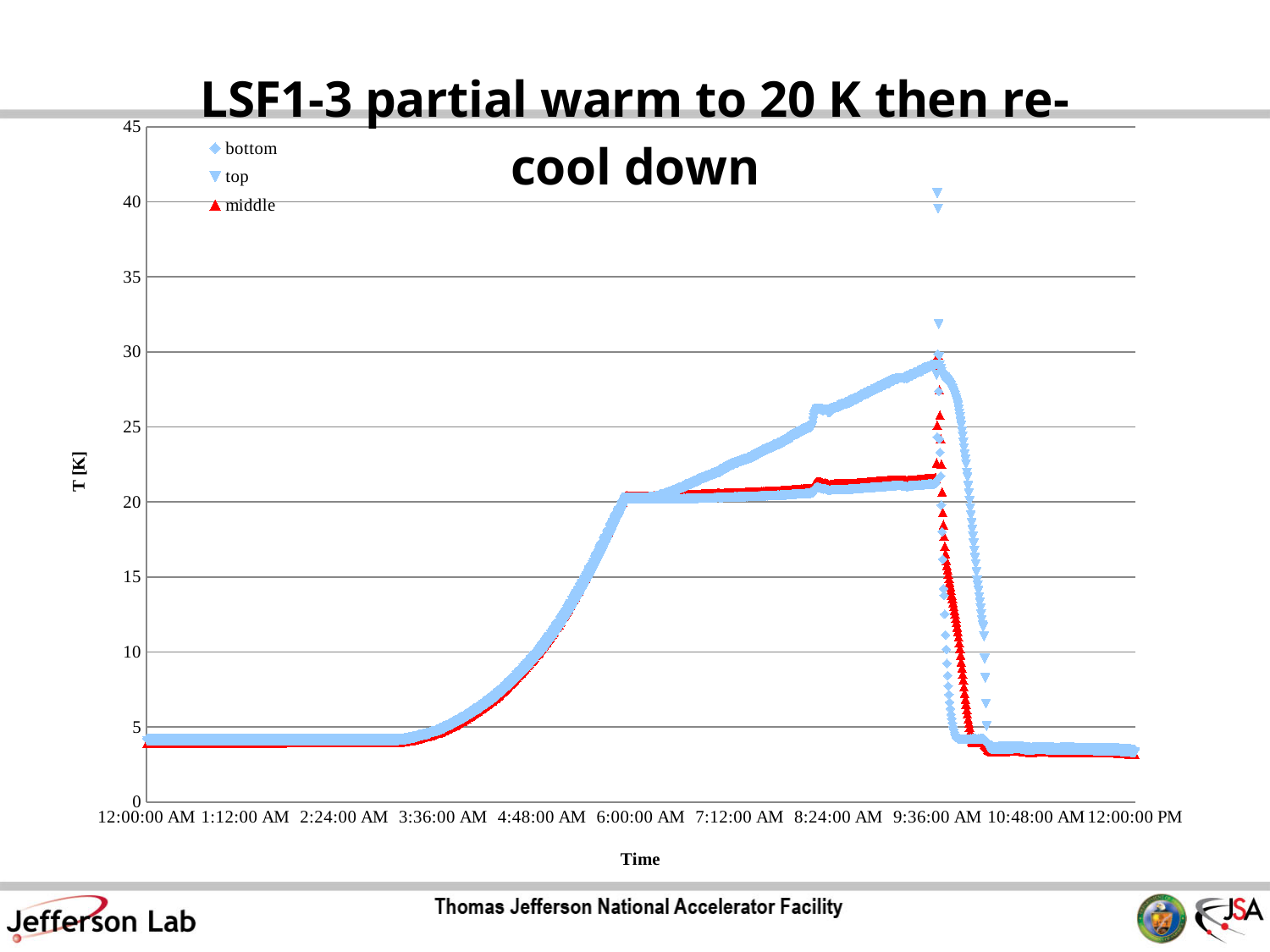
Is the value for the middle series at 8:24:00 AM greater or less than 25? less What are the three series named in the legend? bottom, top, middle Is the value for the bottom series at 9:36:00 AM greater or less than 25? greater What kind of chart is shown on the slide? scatter chart Which series reaches the highest temperature on the chart? top How many series does the legend list? 3 Is the highest value reached by the top series greater or less than 35? greater What is the label of the vertical axis? T [K] At 9:36:00 AM, which series has the higher temperature, bottom or middle? bottom Between 3:36:00 AM and 6:00:00 AM, do the temperatures rise or fall? rise After about 10:00 AM, do the temperatures rise or fall? fall